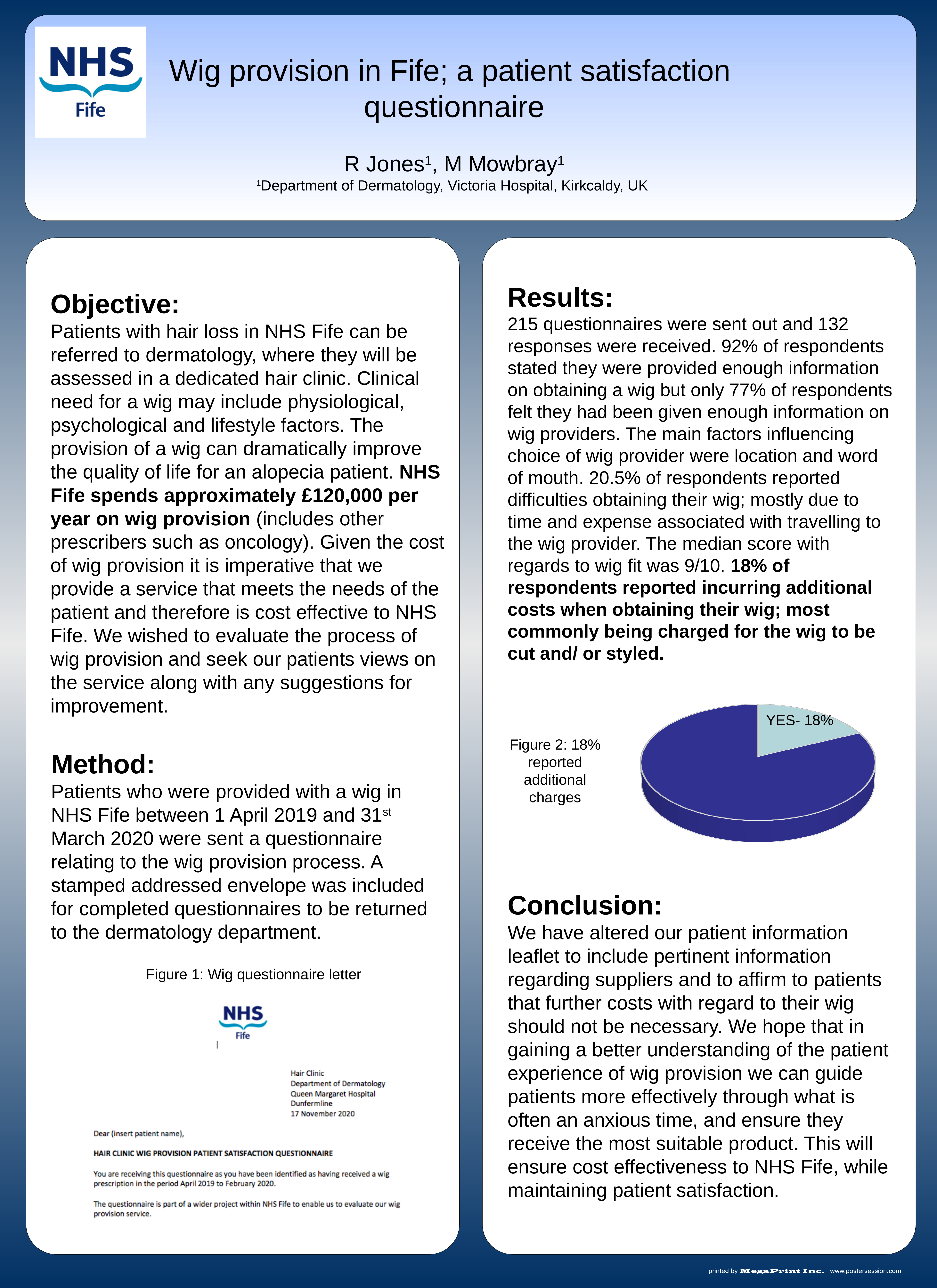
In the Figure 2 pie chart, is the YES slice the larger or the smaller of the two slices? smaller What colour is the YES slice in the Figure 2 pie chart? light blue What kind of chart is Figure 2? pie chart In the Figure 2 pie chart, what percentage is shown for the YES slice? 18% What share of the Figure 2 pie does the YES slice represent? 18% What is the caption of the pie chart on the slide? Figure 2: 18% reported additional charges How many slices does the Figure 2 pie chart have? 2 Which slice of the Figure 2 pie chart is the largest, the YES slice or the unlabeled slice? the unlabeled slice